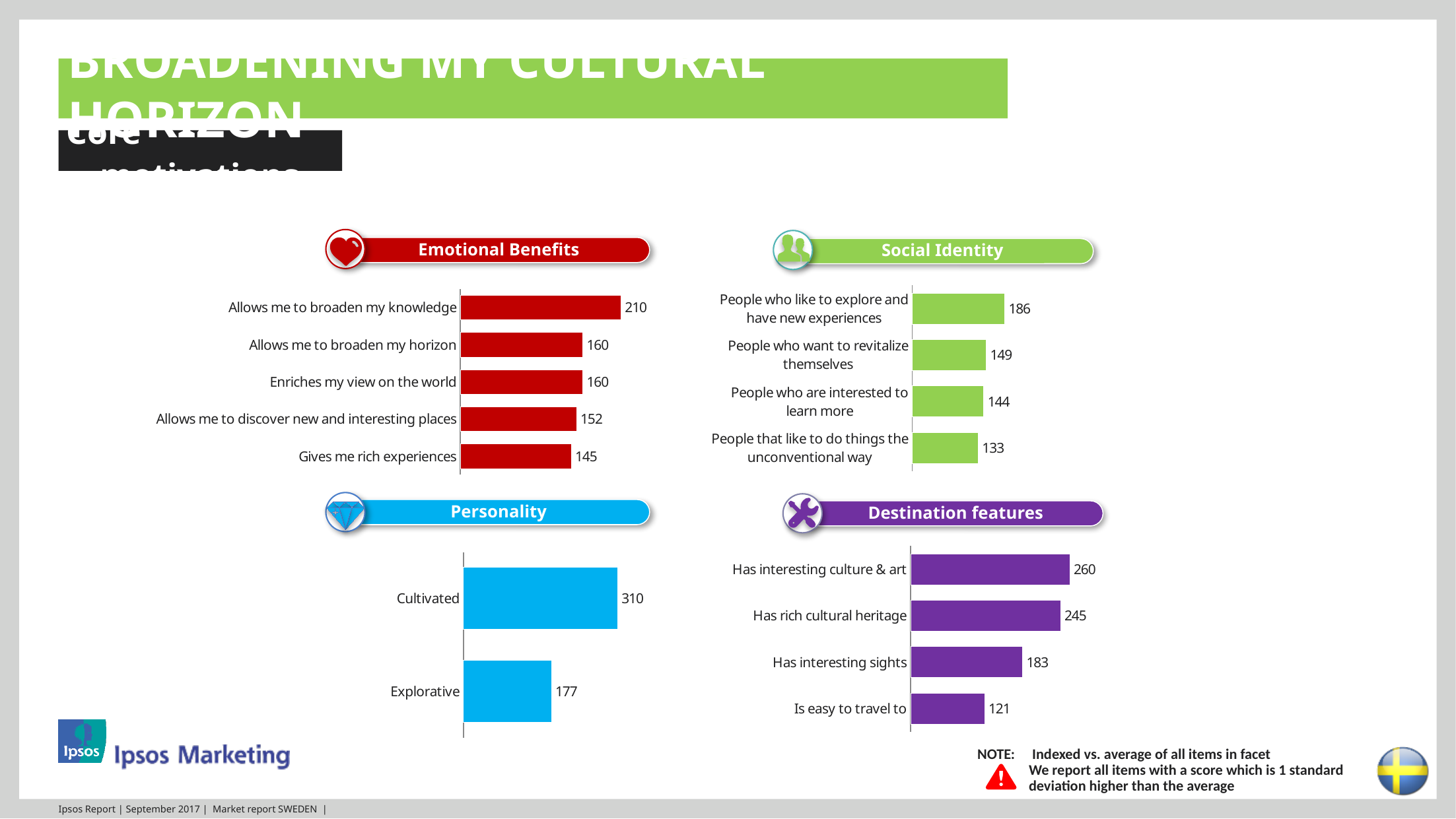
How many categories are shown in the Emotional Benefits chart? 5 What kind of chart is the Destination features chart? Bar chart In the Emotional Benefits chart, what is the value for "Allows me to broaden my knowledge"? 210 In the Personality chart, what is the difference between "Cultivated" and "Explorative"? 133 In the Emotional Benefits chart, which category has the lowest value? Gives me rich experiences In the Social Identity chart, which category has the highest value? People who like to explore and have new experiences In the Personality chart, what is the value for "Explorative"? 177 How many categories are shown in the Social Identity chart? 4 In the Social Identity chart, what is the value for "People who want to revitalize themselves"? 149 In the Destination features chart, which is larger: "Has rich cultural heritage" or "Has interesting sights"? Has rich cultural heritage In the Destination features chart, what is the value for "Is easy to travel to"? 121 In the Emotional Benefits chart, what is the difference between "Allows me to broaden my knowledge" and "Gives me rich experiences"? 65